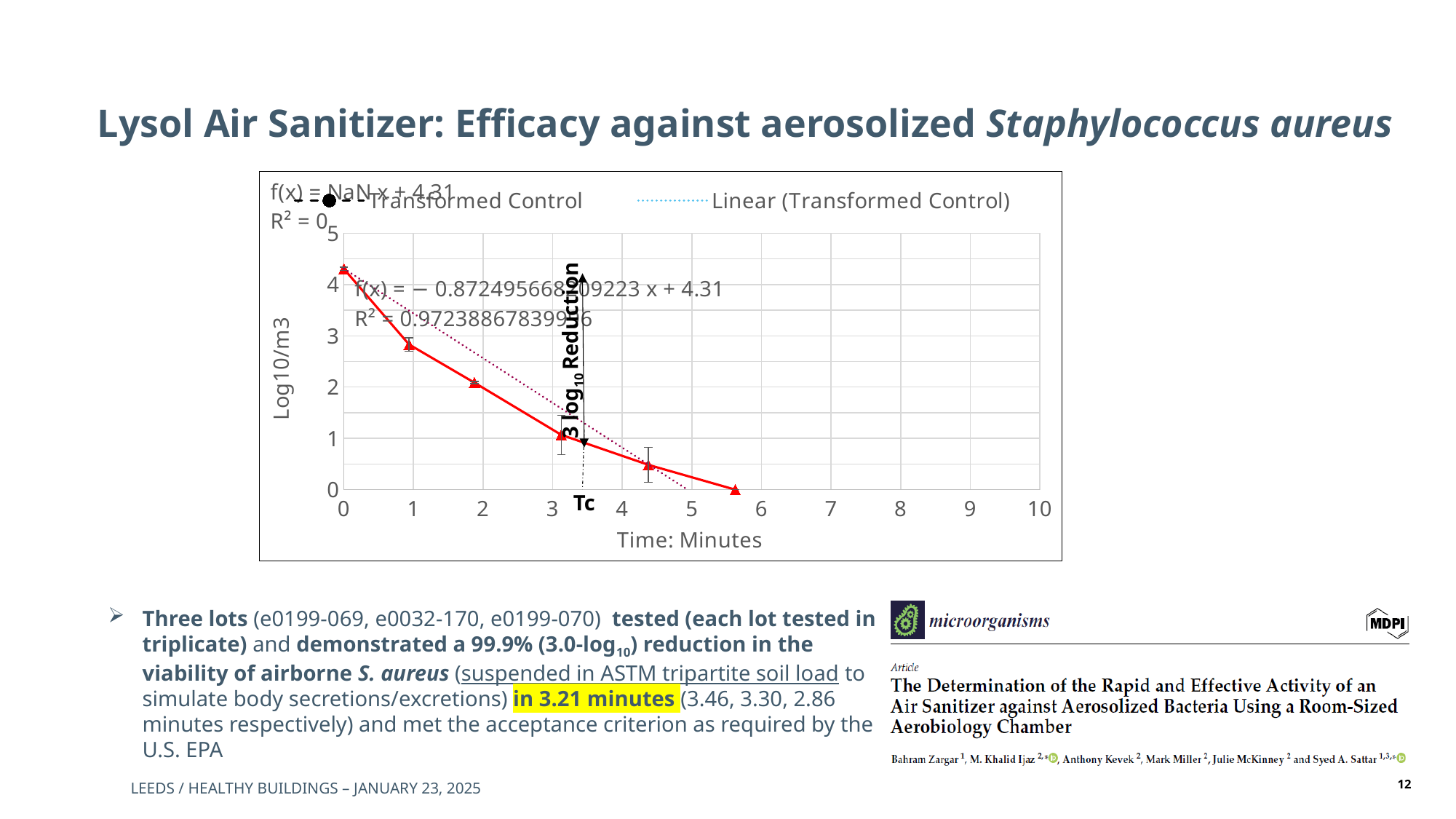
What is the title of the x axis of the chart? Time: Minutes Is the Transformed Control value at 0 minutes greater or less than 4? greater What is the title of the y axis of the chart? Log10/m3 How many series does the chart legend list? 2 Is the Transformed Control value at about 4.4 minutes greater or less than 1? less Is the Transformed Control value at about 2 minutes greater or less than 3? less How many data points are plotted for the Transformed Control series? 6 Do the Transformed Control values rise or fall as time increases along the x axis? fall What is the y-intercept of the linear trendline equation shown on the chart? 4.31 What is the highest value shown on the x axis of the chart? 10 What kind of chart is shown on the slide? line chart